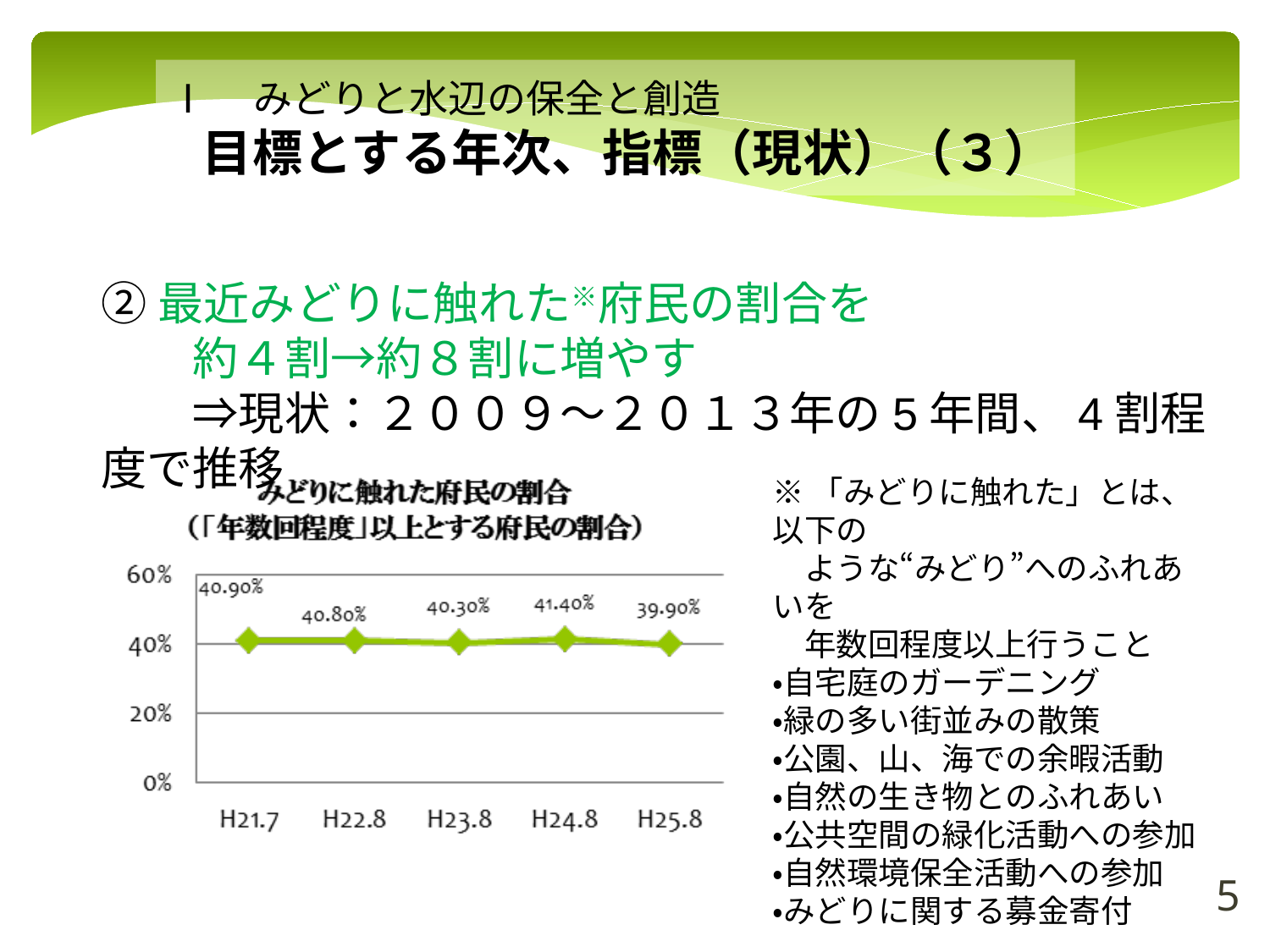
What kind of chart is shown on the slide? line chart Which category has the lowest value? H25.8 What is the difference between the values for H24.8 and H25.8? 1.50% Which category has the highest value? H24.8 What is the value for H25.8? 39.90% What is the value for H24.8? 41.40% Which is larger, the value for H21.7 or the value for H22.8? H21.7 Is the value for H22.8 greater or less than 60%? less What is the value for H23.8? 40.30% What is the title of the chart? みどりに触れた府民の割合（「年数回程度」以上とする府民の割合） How many data points are plotted on the chart? 5 What is the value for H21.7? 40.90%